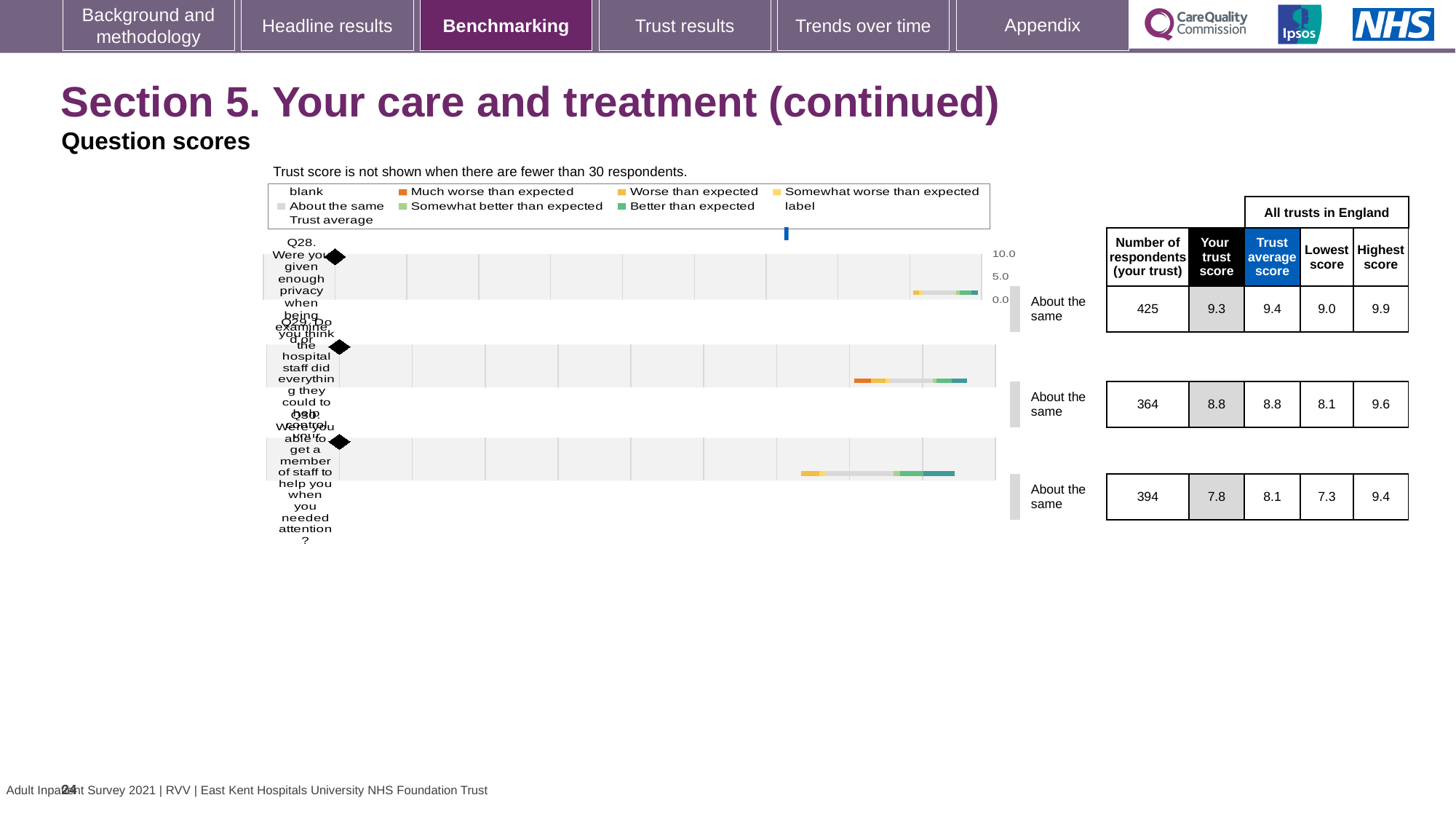
How many questions (Q28, Q29, Q30) are plotted on the slide? 3 What is the highest score across all trusts in England for Q30? 9.4 Which question has the lowest 'Your trust score'? Q30 What benchmark category is shown next to the Q29 chart? About the same What is the trust average score for Q29? 8.8 How many respondents are listed for Q29? 364 Is the trust score marker for Q28 greater or less than 5.0 on the axis? greater What is the 'Your trust score' value for Q28? 9.3 What kind of chart is used to show the question scores on this slide? bar chart What is the difference between the 'Your trust score' for Q28 and for Q30? 1.5 Which question has the highest 'Your trust score'? Q28 For Q30, which is larger: 'Your trust score' or the 'Trust average score'? Trust average score